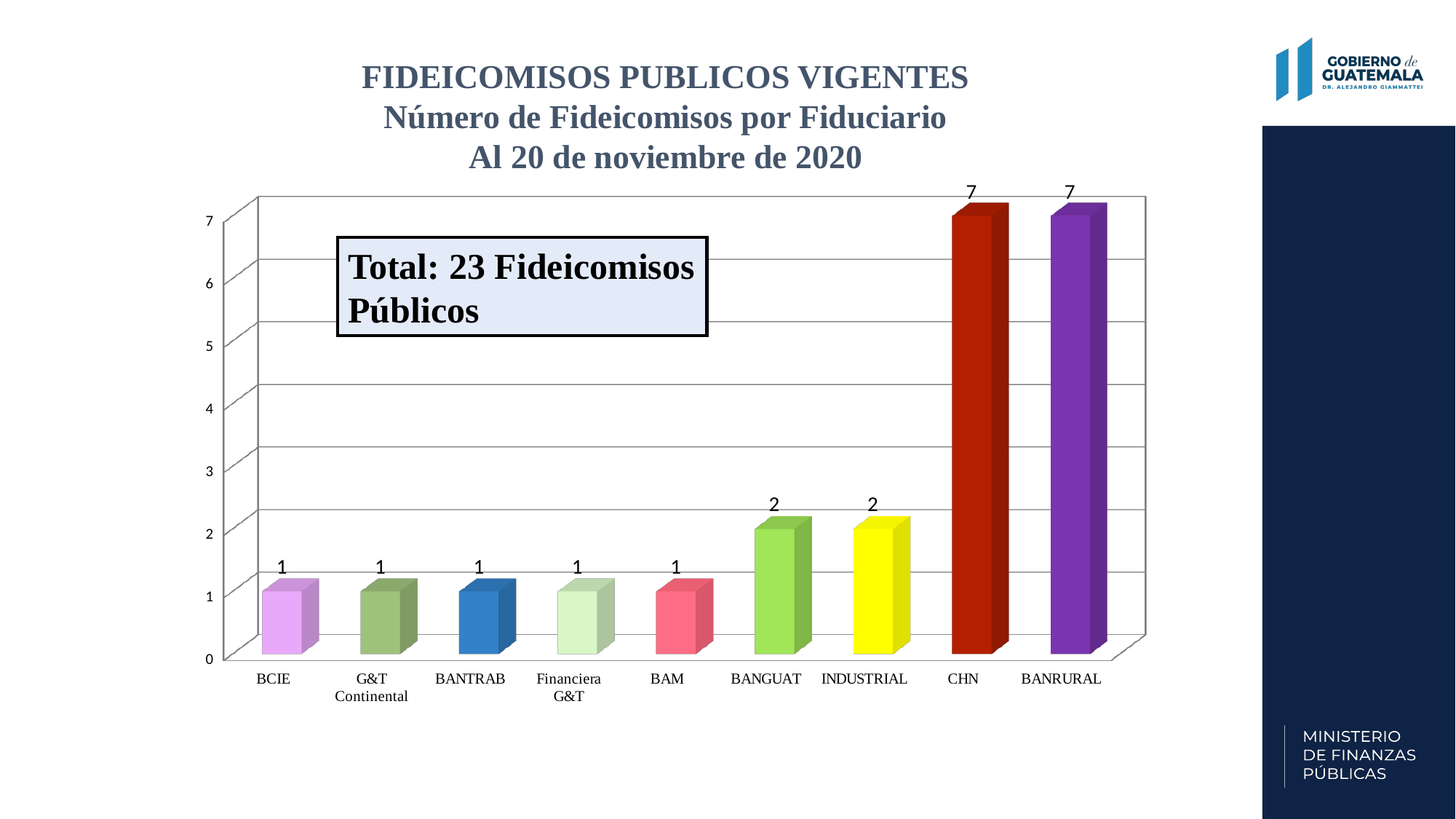
What is the value for CHN? 7 What kind of chart is shown on the slide? bar chart What is the value for INDUSTRIAL? 2 What is the difference between the values for BANRURAL and BANGUAT? 5 What date does the chart title say the data is as of? 20 de noviembre de 2020 Which is larger, the value for INDUSTRIAL or the value for BAM? INDUSTRIAL What is the value for BANGUAT? 2 Is the value for CHN greater or less than 5? greater What is the value for BCIE? 1 What total number of fideicomisos públicos is stated in the box on the chart? 23 How many categories (fiduciarios) are shown on the x axis? 9 Do the values generally rise or fall from left to right along the x axis? rise